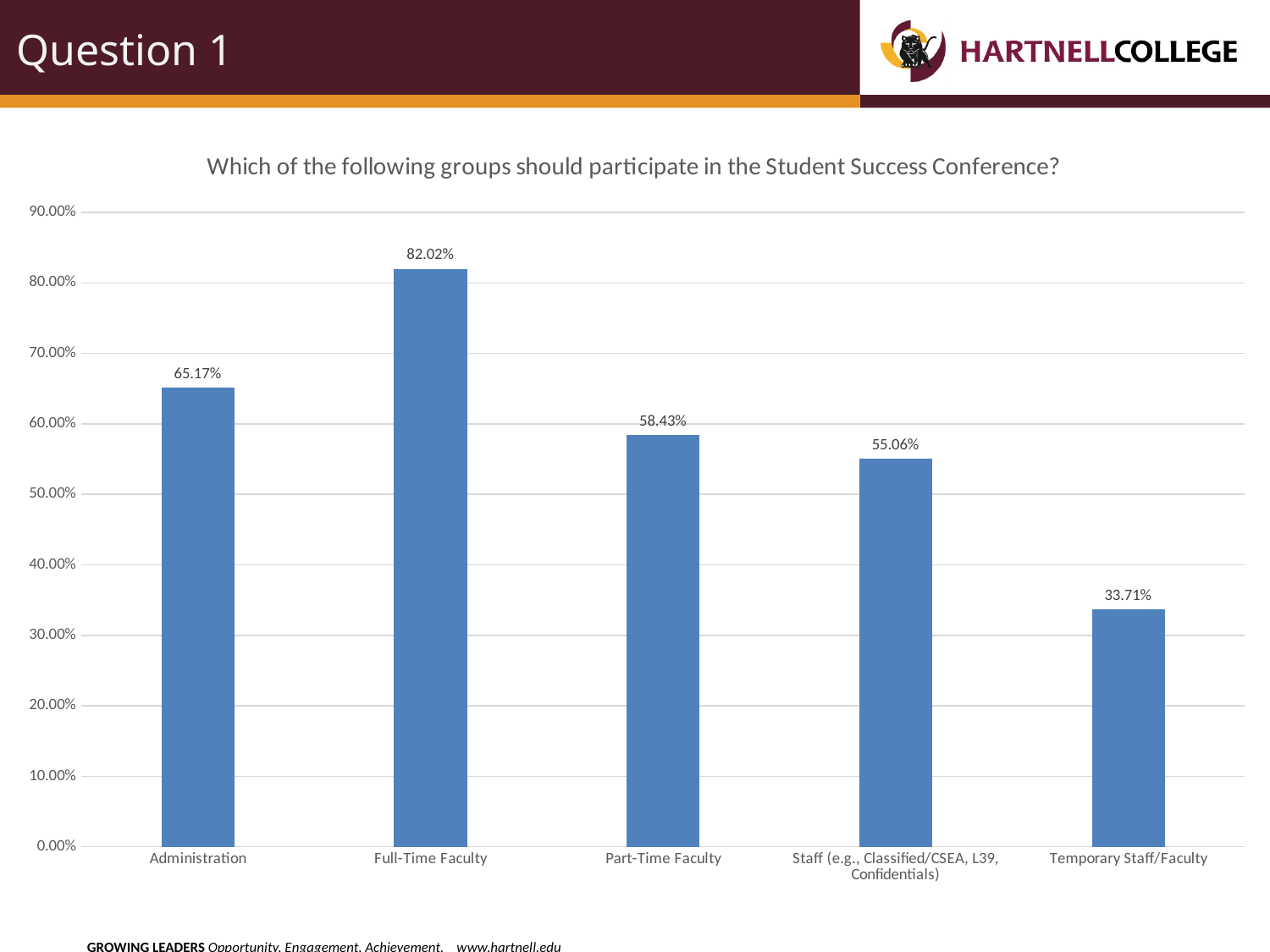
What is the value shown for Temporary Staff/Faculty? 33.71% Is the value for Part-Time Faculty greater or less than 60.00%? less What is the title of the chart? Which of the following groups should participate in the Student Success Conference? What is the difference between the values for Staff (e.g., Classified/CSEA, L39, Confidentials) and Temporary Staff/Faculty? 21.35% How many groups are shown on the chart? 5 What kind of chart is shown on the slide? bar chart What percentage of respondents said Administration should participate in the Student Success Conference? 65.17% Which group has the lowest percentage? Temporary Staff/Faculty What is the difference between the values for Full-Time Faculty and Part-Time Faculty? 23.59% Which group has the highest percentage? Full-Time Faculty Which is larger, the value for Administration or the value for Staff (e.g., Classified/CSEA, L39, Confidentials)? Administration What is the value shown for Full-Time Faculty? 82.02%